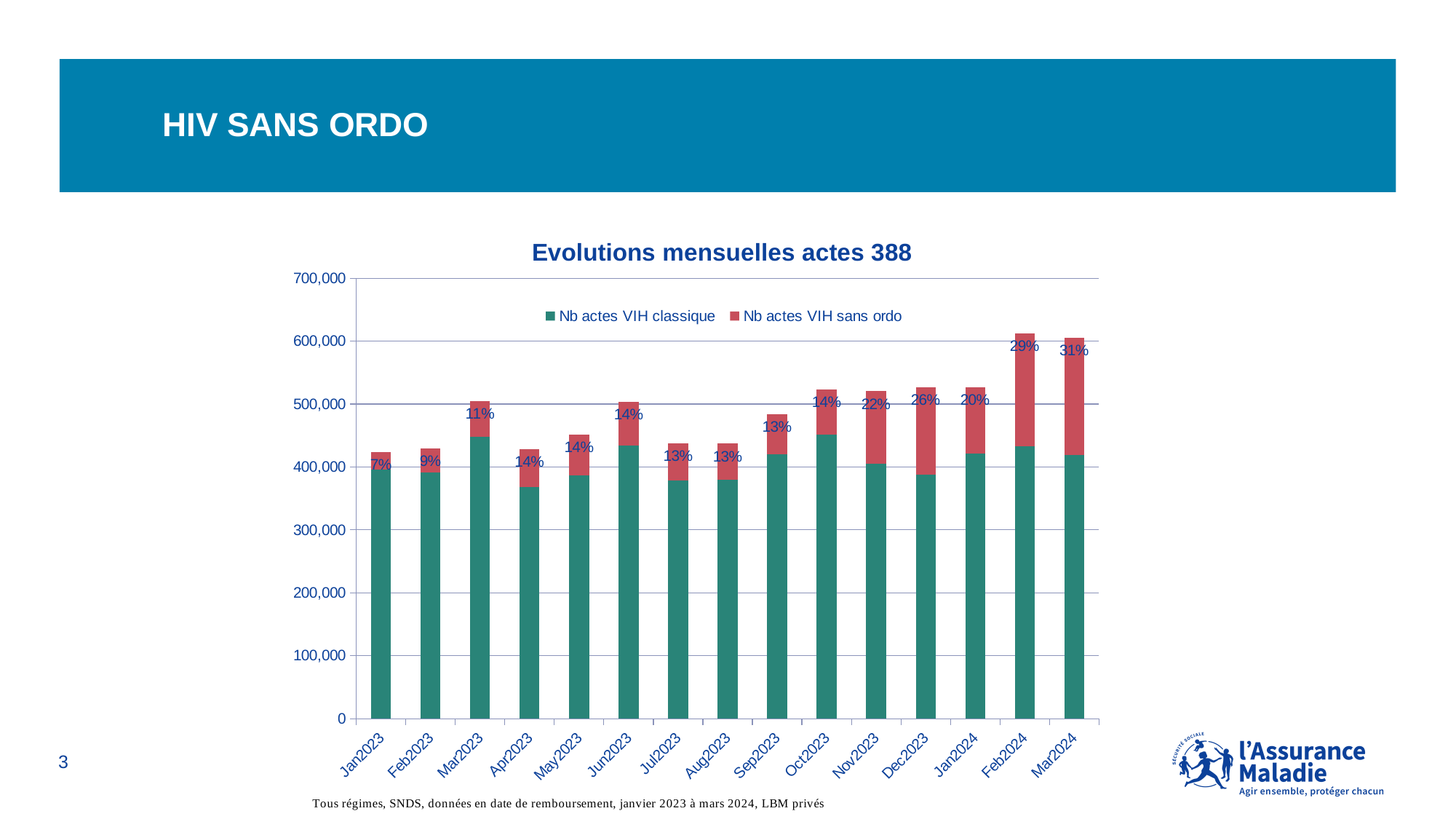
What type of chart is shown on the slide? Stacked bar chart Is the total bar height for Jul2023 greater or less than 500,000? less Is the total bar height for Feb2024 greater or less than 600,000? greater Which month has the highest percentage label on its bar? Mar2024 What is the title of the chart? Evolutions mensuelles actes 388 How many series does the chart legend list? 2 What percentage label is shown on the bar for Jan2023? 7% What percentage label is shown on the bar for Mar2024? 31% What percentage label is shown on the bar for Nov2023? 22% Which series is shown in red in the chart? Nb actes VIH sans ordo Which month has the lowest percentage label on its bar? Jan2023 How many months are shown on the x axis of the chart? 15